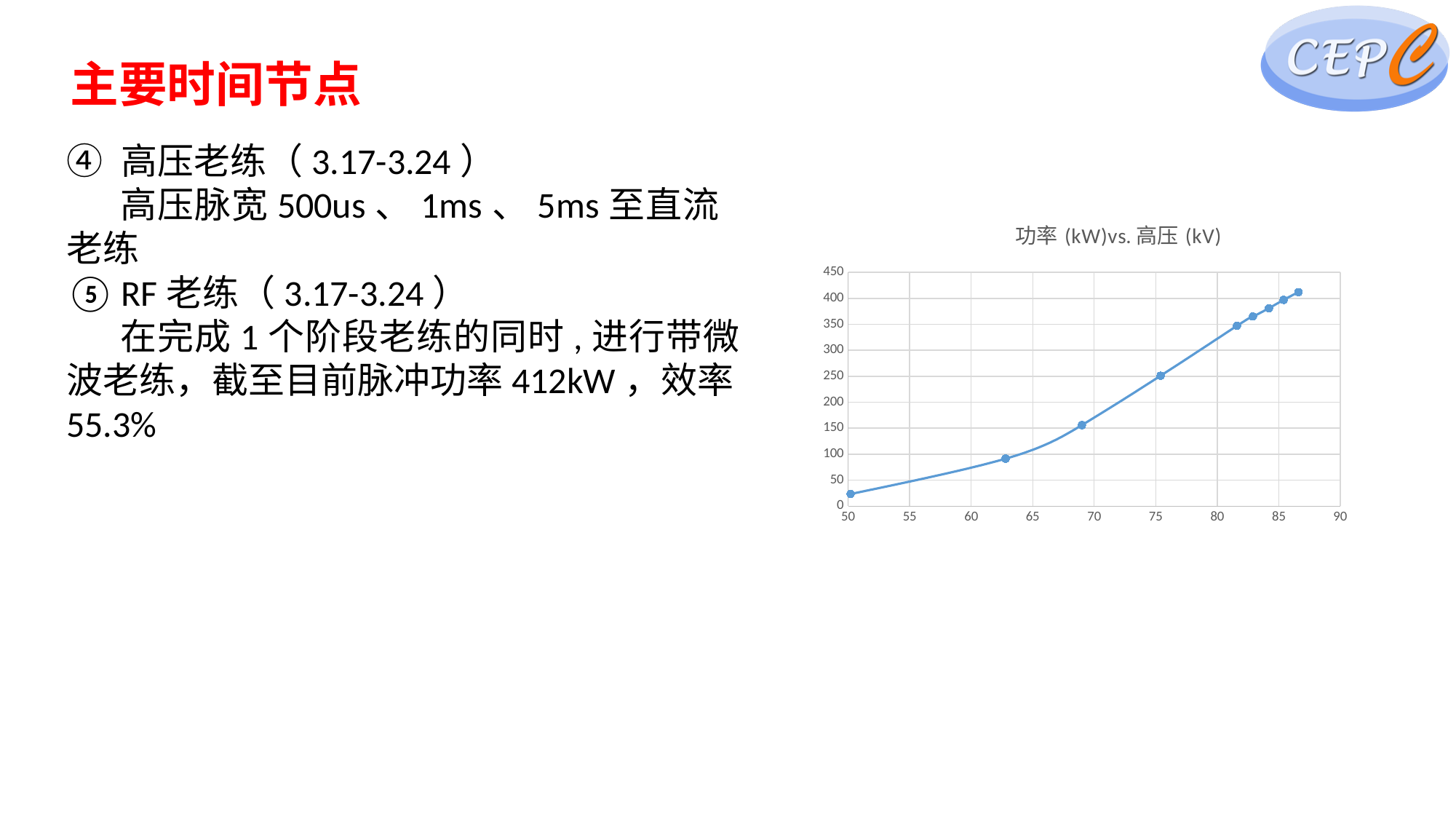
Is the value at the data point near x = 69 greater or less than 100? greater How many data points are plotted on the chart? 9 Is the value at the data point near x = 75 greater or less than 200? greater Is the value at the first data point (x = 50) greater or less than 50? less What kind of chart is shown on the slide? line chart Which data point has the highest value, the one at the smallest x or the one at the largest x? the one at the largest x What is the maximum value shown on the y axis? 450 Do the plotted values rise or fall as the x axis increases from 50 to 90? rise What is the title of the chart? 功率 (kW)vs. 高压 (kV)